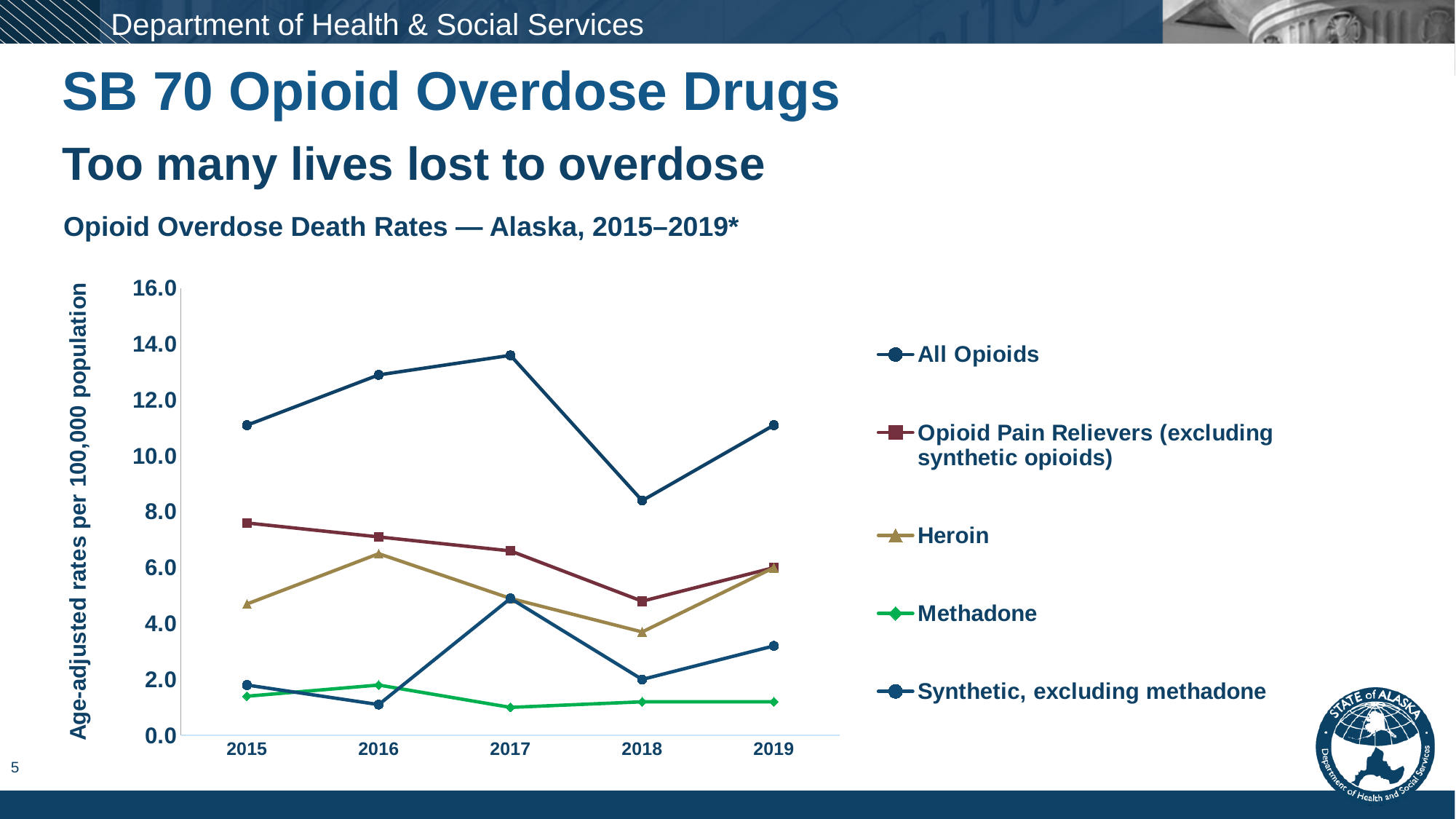
How many series does the legend list? 5 Which series had the lowest death rate in 2017? Methadone In which year was the All Opioids death rate lowest? 2018 How many years are plotted along the x axis? 5 Did the Opioid Pain Relievers (excluding synthetic opioids) rate rise or fall from 2015 to 2018? fall Is the Opioid Pain Relievers (excluding synthetic opioids) value for 2015 greater or less than 6.0? greater What is the label on the y axis of the chart? Age-adjusted rates per 100,000 population In which year was the All Opioids death rate highest? 2017 Is the All Opioids value for 2017 greater or less than 12.0? greater Is the All Opioids value for 2018 greater or less than 10.0? less In 2016, which had the higher death rate: Heroin or Methadone? Heroin What kind of chart is shown on the slide? line chart